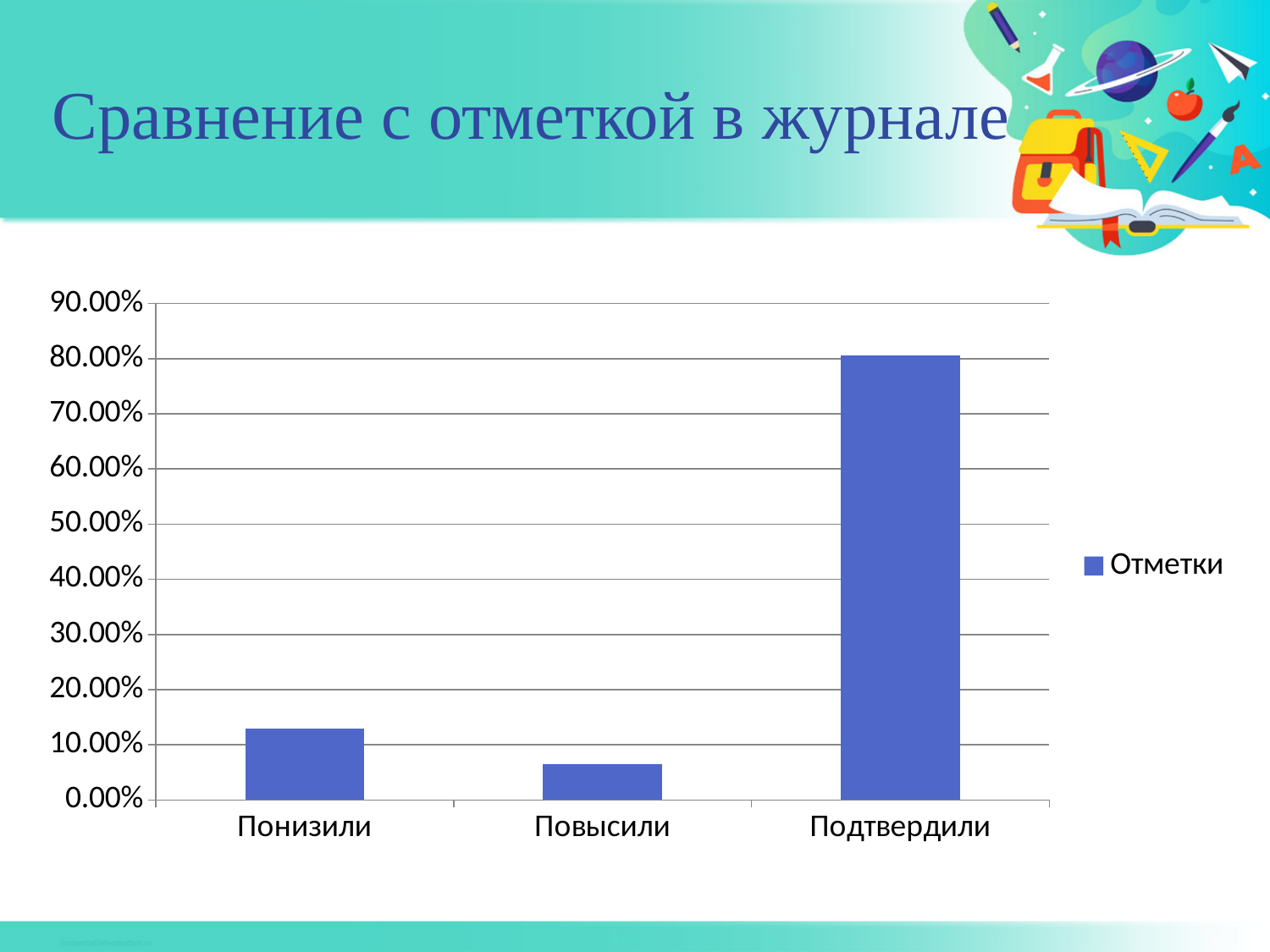
What is the name of the series shown in the chart legend? Отметки Which category has the lowest value in the chart? Повысили Which is larger, the value for Понизили or the value for Повысили? Понизили How many series does the chart legend list? 1 Is the value for Подтвердили greater or less than 70.00%? greater What kind of chart is shown on the slide? bar chart How many categories are shown on the x axis of the chart? 3 What is the title of the slide containing the chart? Сравнение с отметкой в журнале Is the value for Понизили greater or less than 10.00%? greater Which category has the highest value in the chart? Подтвердили Is the value for Понизили greater or less than 20.00%? less